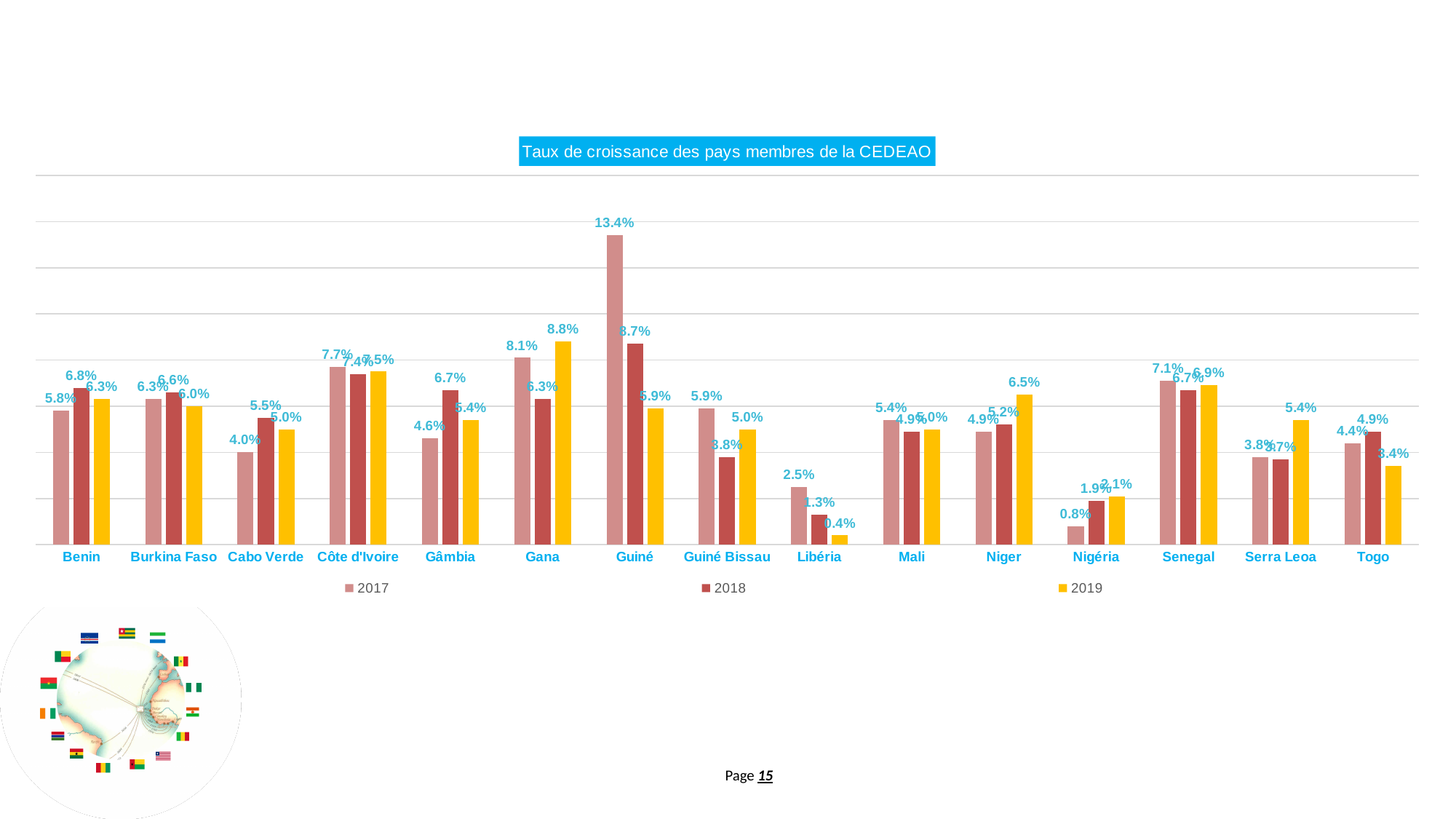
What is the difference between the 2017 and 2019 values for Guiné? 7.5% What is the 2019 value for Gana? 8.8% What is the 2018 value for Libéria? 1.3% Which country has the lowest 2019 value? Libéria How many countries are shown on the x axis? 15 What is the 2017 value for Guiné? 13.4% Which country has the highest 2017 value? Guiné Do the values for Nigéria rise or fall from 2017 to 2019? Rise What type of chart is shown on the slide? Bar chart How many series does the legend list? 3 What is the title of the chart? Taux de croissance des pays membres de la CEDEAO Which is larger for Niger: the 2018 value or the 2019 value? 2019